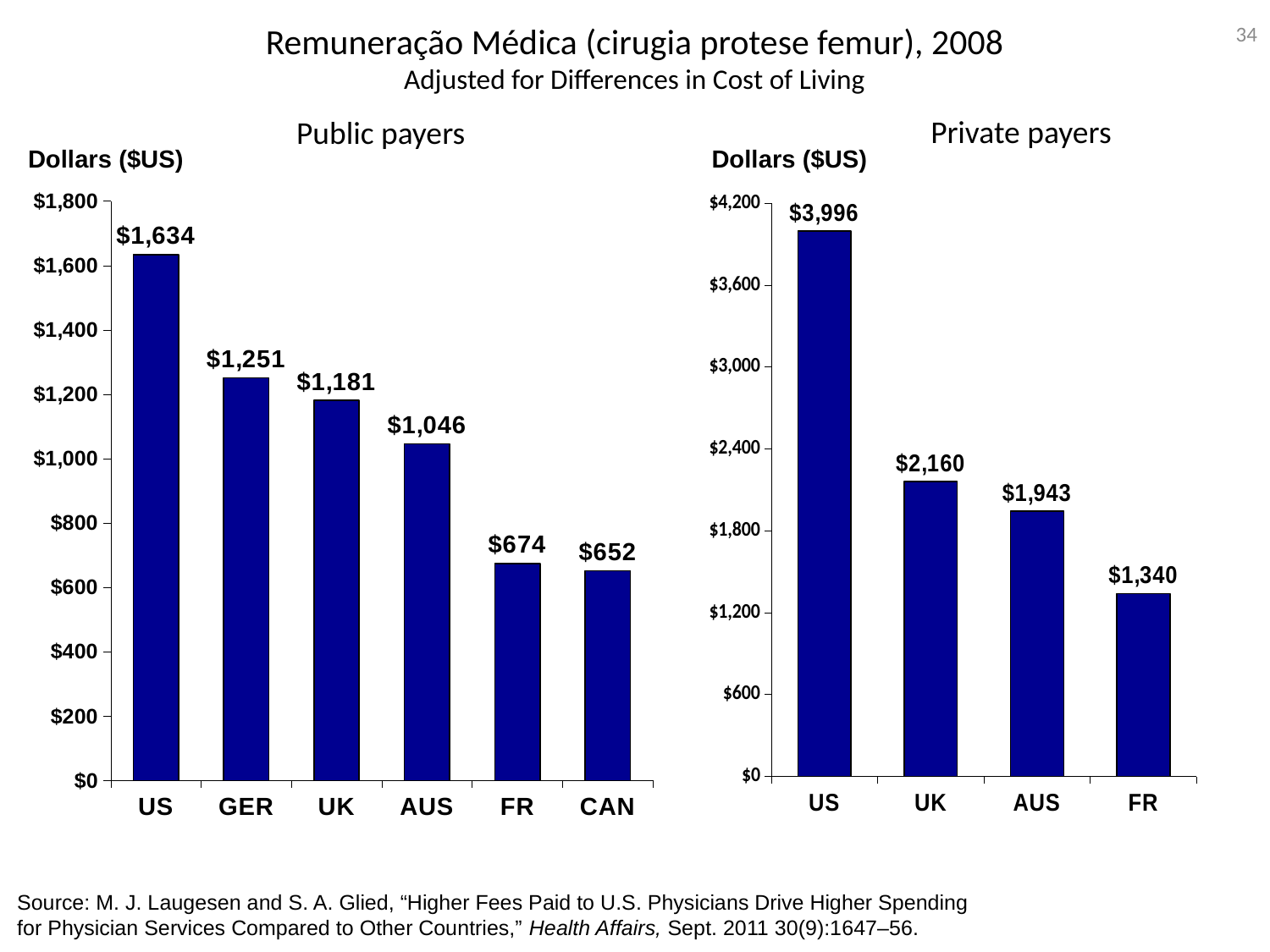
In the Private payers chart, what is the difference between the UK and FR values? $820 In the Public payers chart, do the values rise or fall from left to right? fall In the Public payers chart, which is larger, the value for AUS or the value for FR? AUS In the Private payers chart, what is the value for AUS? $1,943 In the Public payers chart, what is the difference between the US and UK values? $453 In the Private payers chart, which country has the highest value? US In the Private payers chart, is the value for UK greater or less than $2,400? less In the Public payers chart, which country has the lowest value? CAN How many countries are shown in the Public payers chart? 6 In the Public payers chart, what is the value for GER? $1,251 How many countries are shown in the Private payers chart? 4 What kind of chart is the Private payers chart? bar chart